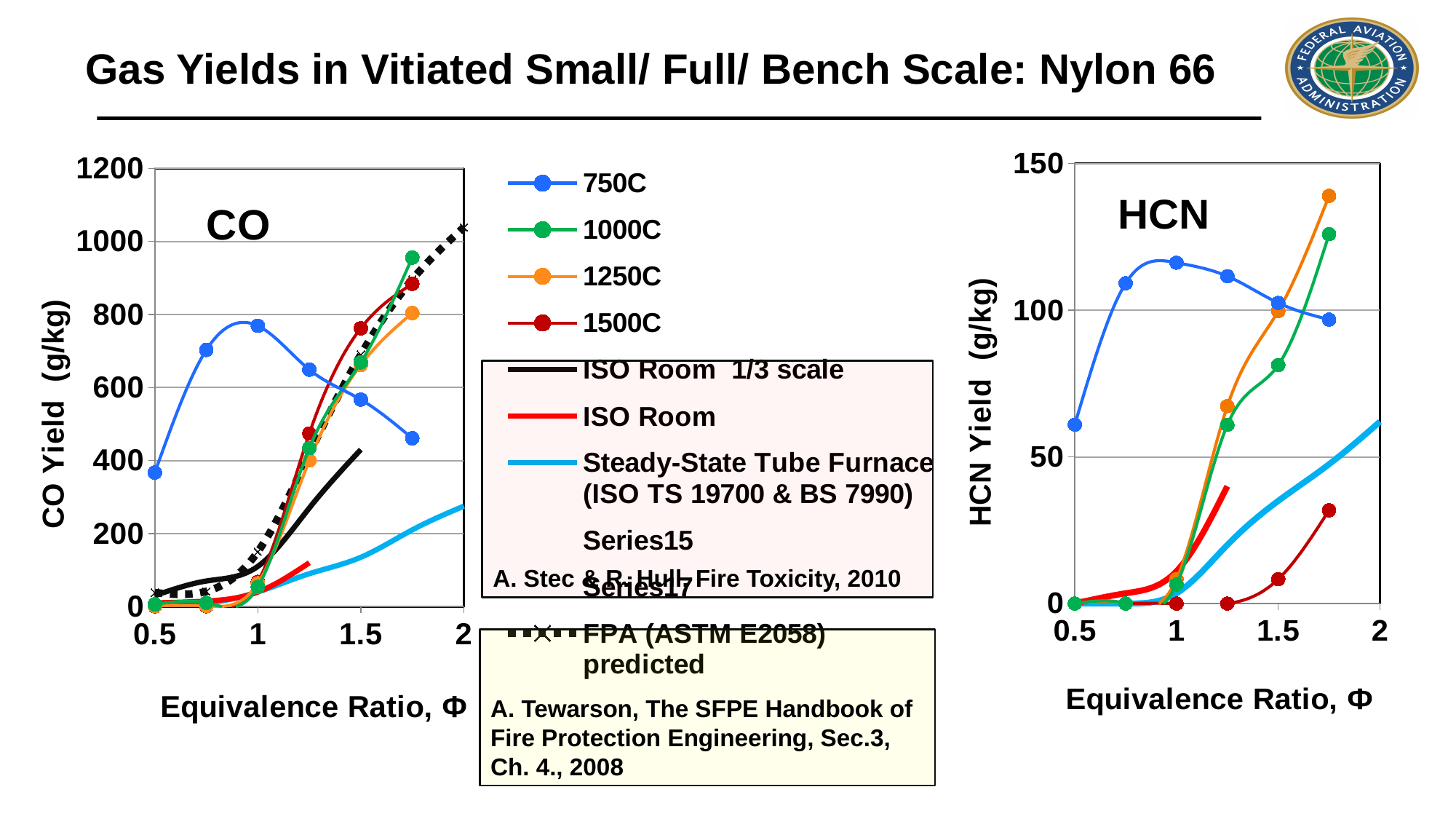
In the CO chart, at an equivalence ratio of 0.5, which is larger: the 750C value or the 1000C value? 750C In the HCN chart, is the value of the 1250C series at an equivalence ratio of 1.75 greater or less than 100? greater In the HCN chart, which series reaches the highest value at an equivalence ratio of 1.75? 1250C In the HCN chart, how many data points are plotted for the 750C series? 6 What kind of chart is the CO chart on the left? line chart In the HCN chart, does the 1500C series rise or fall as the equivalence ratio increases from 1.25 to 1.75? rise In the CO chart, which series has the highest value at an equivalence ratio of 1? 750C What is the y-axis label of the HCN chart? HCN Yield (g/kg) In the HCN chart, is the value of the 1500C series at an equivalence ratio of 1.75 greater or less than 50? less In the CO chart, is the value of the 750C series at an equivalence ratio of 1 greater or less than 600? greater